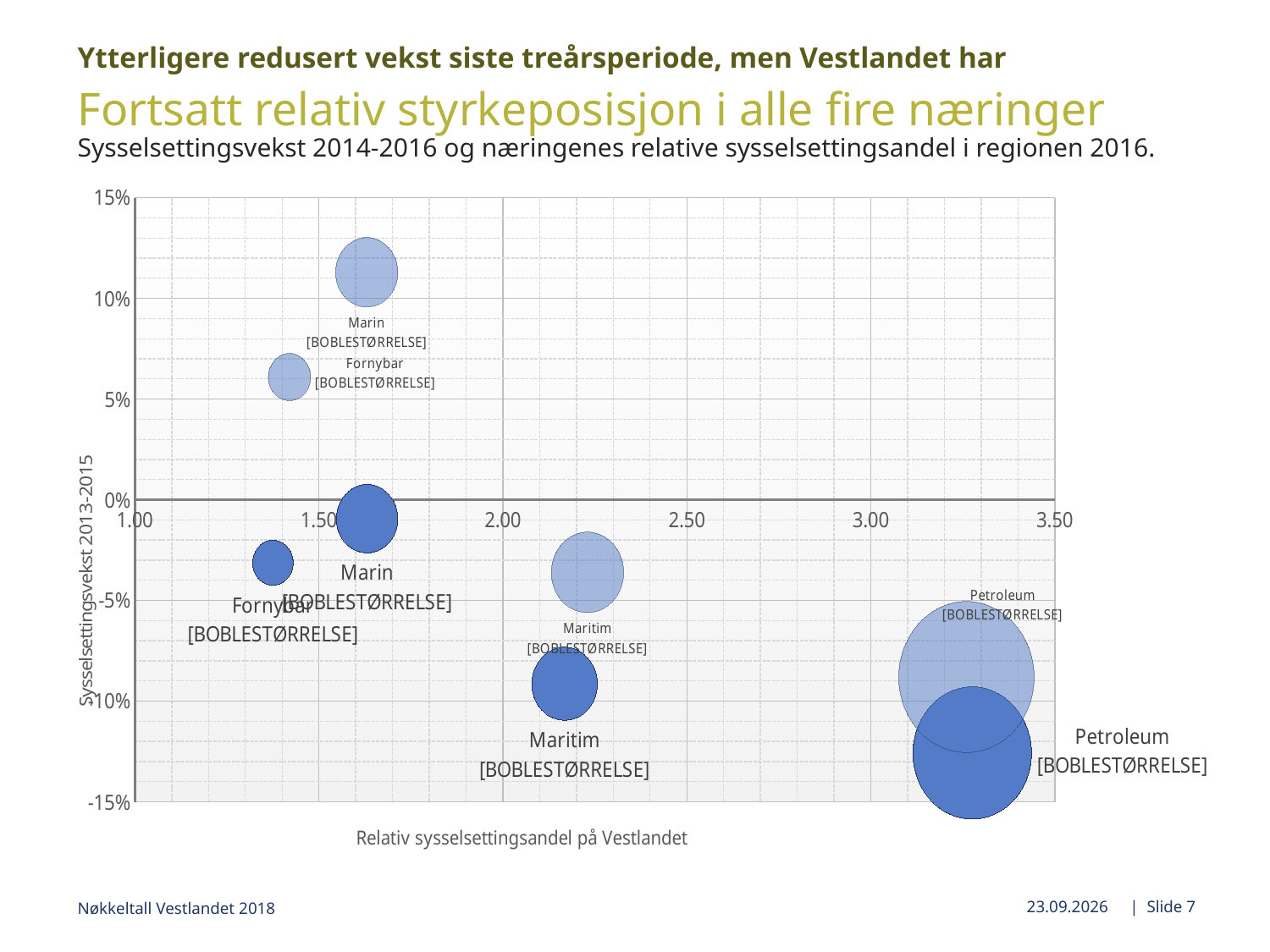
Which industry has the light-blue bubble with the highest employment growth? Marin Which industry has the dark-blue bubble with the lowest employment growth? Petroleum What is the title of the y axis? Sysselsettingsvekst 2013-2015 Is the relative employment share of Petroleum greater or less than 3.00? greater Which has the higher employment growth among the dark-blue bubbles, Maritim or Petroleum? Maritim Which industry is plotted furthest to the right on the x axis (highest relative employment share)? Petroleum What kind of chart is shown on the slide? bubble chart What is the title of the x axis? Relativ sysselsettingsandel på Vestlandet How many industries (næringer) are labelled in the chart? 4 Is the employment growth of the dark-blue Petroleum bubble greater or less than -10%? less Is the employment growth of the light-blue Fornybar bubble greater or less than 5%? greater